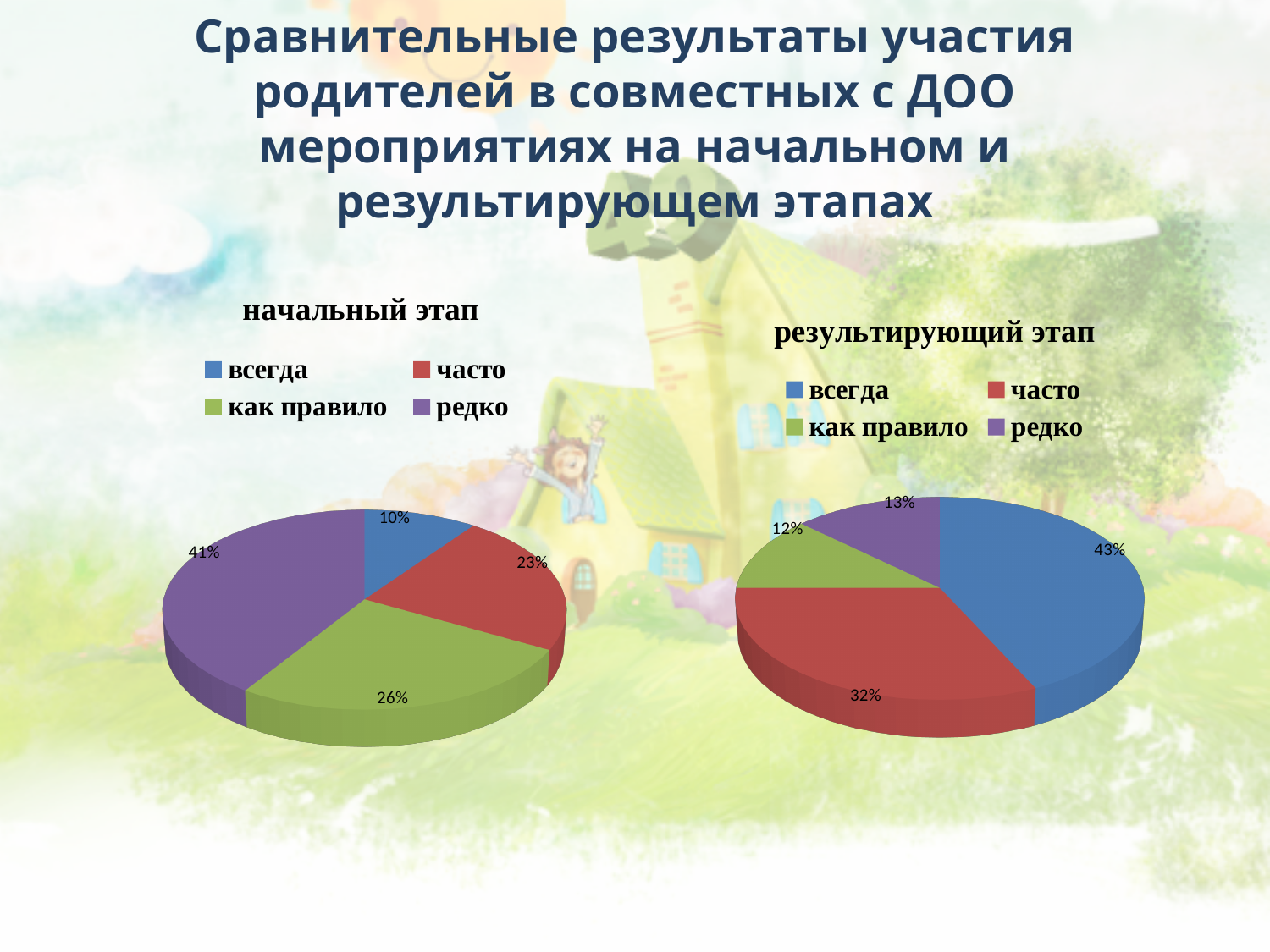
How many categories does the chart titled «начальный этап» show? 4 In the chart titled «начальный этап», what is the difference between «как правило» and «часто»? 3% In the chart titled «начальный этап», which category has the largest slice? редко In the chart titled «результирующий этап», what is the difference between «всегда» and «часто»? 11% In the chart titled «результирующий этап», which category has the smallest slice? как правило In the chart titled «начальный этап», what is the value for «всегда»? 10% In the chart titled «начальный этап», which colour represents «как правило»? green In the chart titled «результирующий этап», what is the value for «всегда»? 43% In the chart titled «начальный этап», what is the value for «редко»? 41% In the chart titled «результирующий этап», what is the value for «как правило»? 12% What type of chart is the chart titled «результирующий этап»? pie chart In the chart titled «результирующий этап», which is larger: «часто» or «редко»? часто